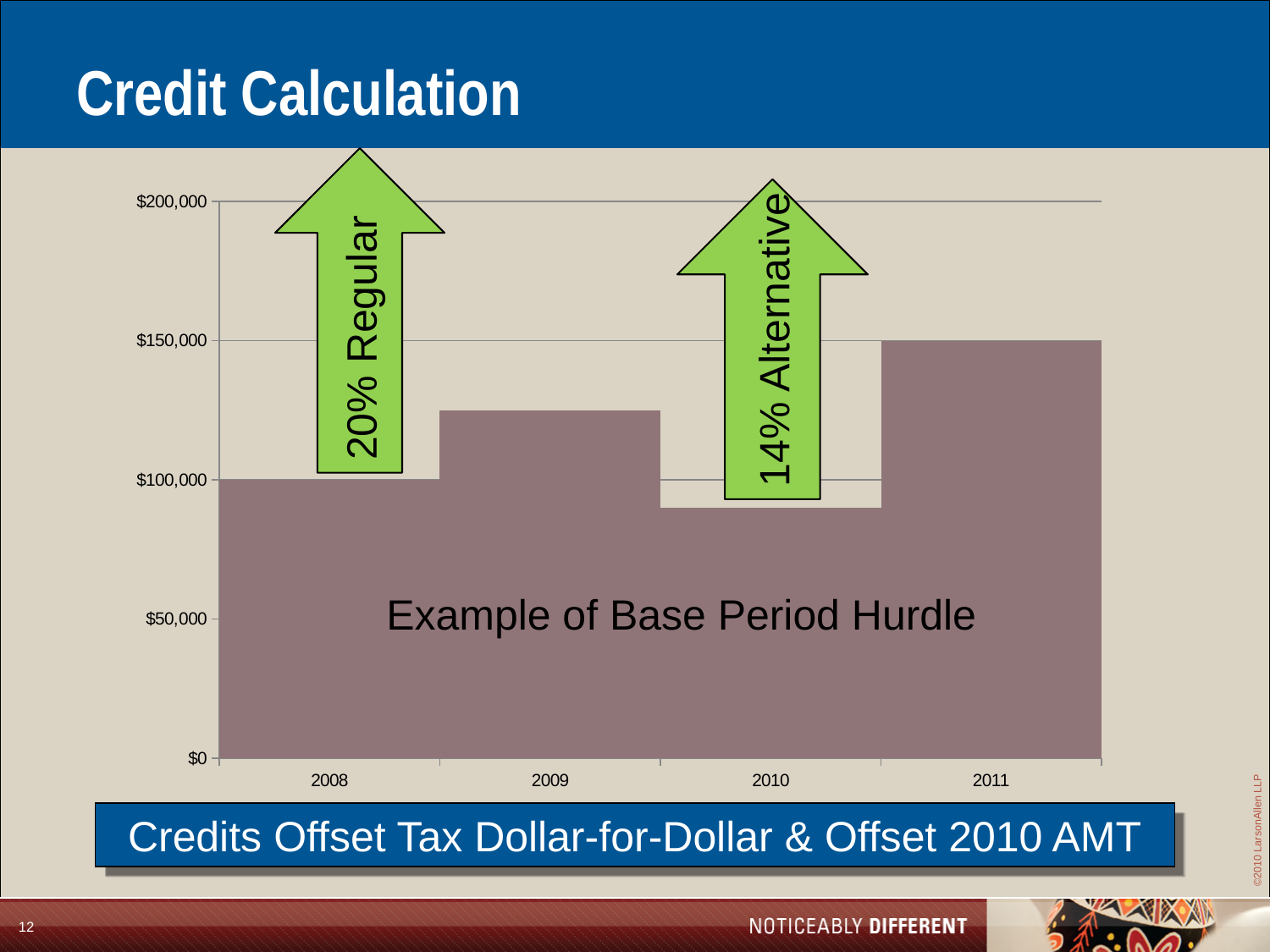
Is the value for 2009 greater or less than $100,000? greater Which year has the lowest value? 2010 What is the value for 2011? $150,000 What kind of chart is shown on the slide? bar chart Which is larger, the value for 2009 or the value for 2010? 2009 How many years are shown on the x axis? 4 What text is written inside the chart area across the bars? Example of Base Period Hurdle What is the difference between the value for 2011 and the value for 2008? $50,000 What is the value for 2008? $100,000 Is the value for 2010 greater or less than $100,000? less Which year has the highest value? 2011 Is the value for 2009 greater or less than $150,000? less